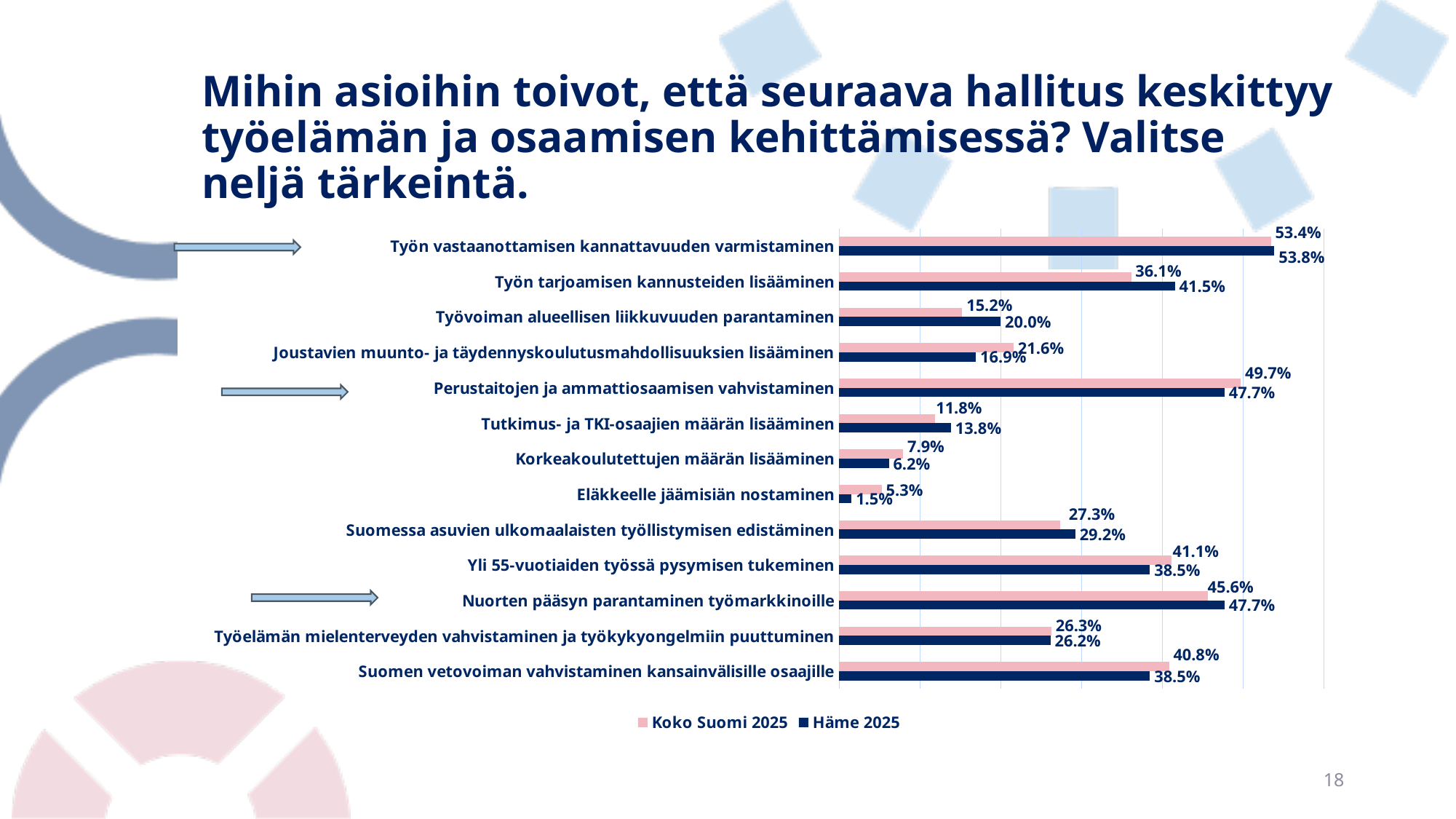
For Joustavien muunto- ja täydennyskoulutusmahdollisuuksien lisääminen, which series has the larger value, Koko Suomi 2025 or Häme 2025? Koko Suomi 2025 What is the Koko Suomi 2025 value for Eläkkeelle jäämisiän nostaminen? 5.3% Which category has the lowest Koko Suomi 2025 value? Eläkkeelle jäämisiän nostaminen How many series does the legend list? 2 Which category has the highest Häme 2025 value? Työn vastaanottamisen kannattavuuden varmistaminen What is the difference between the Häme 2025 and Koko Suomi 2025 values for Työvoiman alueellisen liikkuvuuden parantaminen? 4.8% What is the Koko Suomi 2025 value for Nuorten pääsyn parantaminen työmarkkinoille? 45.6% What is the Häme 2025 value for Työn tarjoamisen kannusteiden lisääminen? 41.5% How many categories are shown in the chart? 13 What is the difference between the Koko Suomi 2025 and Häme 2025 values for Yli 55-vuotiaiden työssä pysymisen tukeminen? 2.6% Which series is shown in dark blue in the legend? Häme 2025 What kind of chart is shown on the slide? bar chart